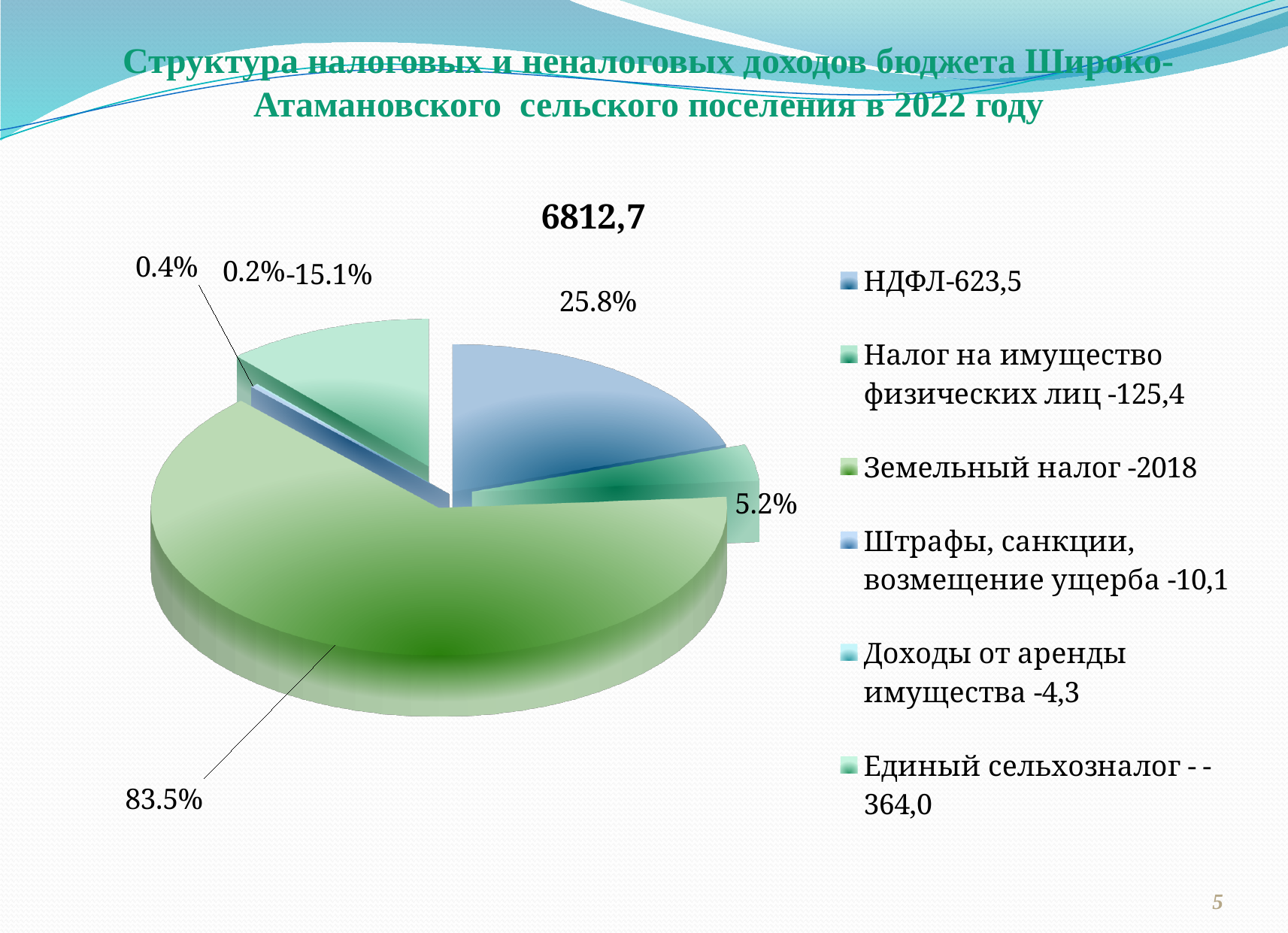
What value is given in the legend for Земельный налог? 2018 What kind of chart is shown on the slide? pie chart Which category has the largest slice of the pie chart? Земельный налог What percentage label is shown for the Земельный налог slice? 83.5% What percentage label is shown for the Налог на имущество физических лиц slice? 5.2% What percentage label is shown for the НДФЛ slice? 25.8% By how many percentage points does the НДФЛ slice exceed the Налог на имущество физических лиц slice? 20.6 What is the title shown above the pie chart? 6812,7 How many categories does the legend of the pie chart list? 6 Which slice is larger, НДФЛ or Налог на имущество физических лиц? НДФЛ What value is given in the legend for Штрафы, санкции, возмещение ущерба? 10,1